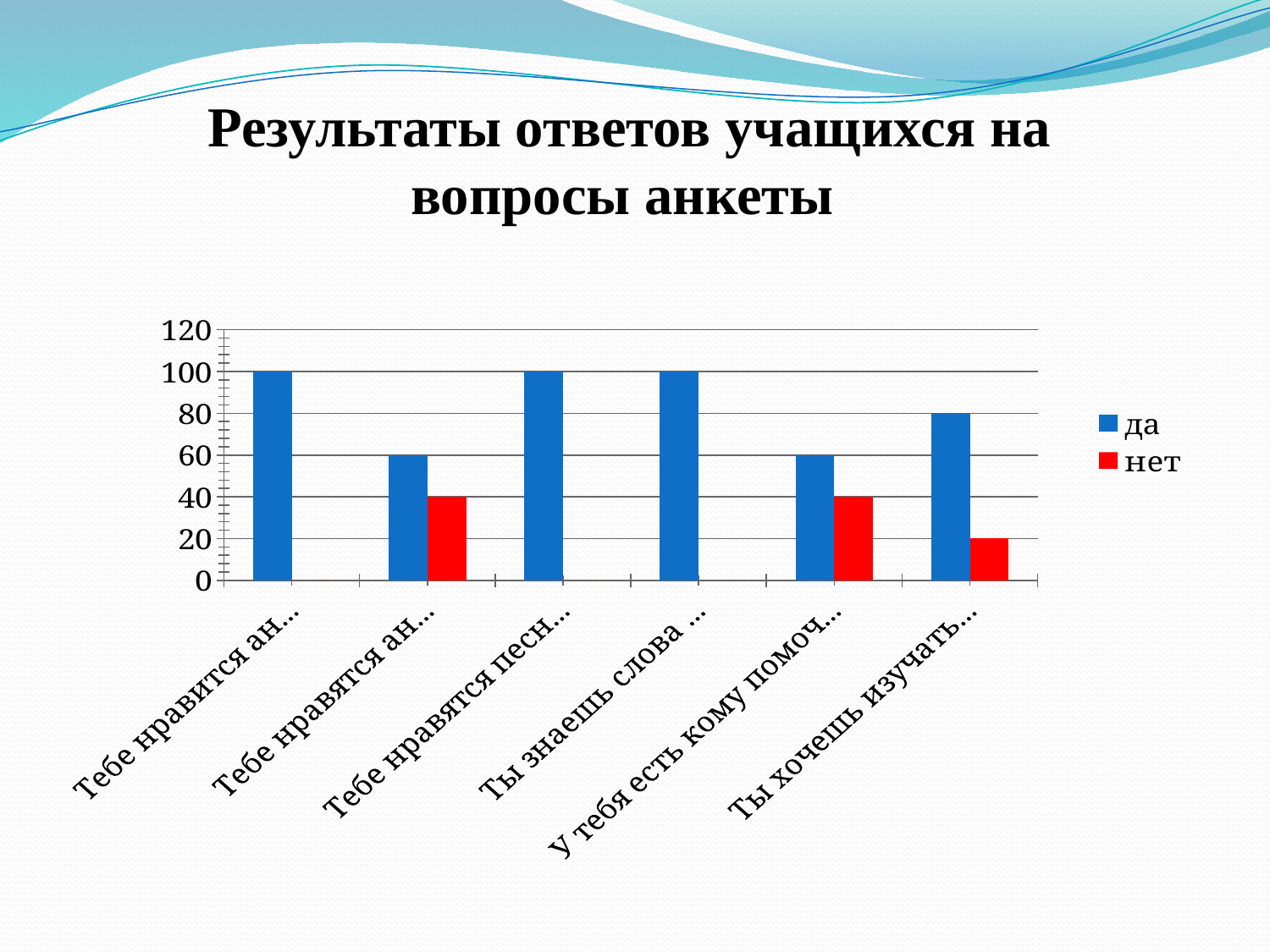
For the category "У тебя есть кому помоч...", which is larger, да or нет? да What is the value of the нет series for the last category, "Ты хочешь изучать..."? 20 For the category "Ты хочешь изучать...", what is the difference between the да value and the нет value? 60 What kind of chart is shown on the slide? bar chart Among the categories that have a red нет bar, which has the smallest нет value? Ты хочешь изучать... Is the да value for the first category, "Тебе нравится ан...", greater or less than 80? greater What is the value of the да series for the last category, "Ты хочешь изучать..."? 80 How many categories are shown along the x axis? 6 What is the value of the да series for the fourth category, "Ты знаешь слова ..."? 100 What are the two entries in the chart legend? да, нет What is the value of the нет series for the second category, "Тебе нравятся ан..."? 40 How many series does the legend list? 2